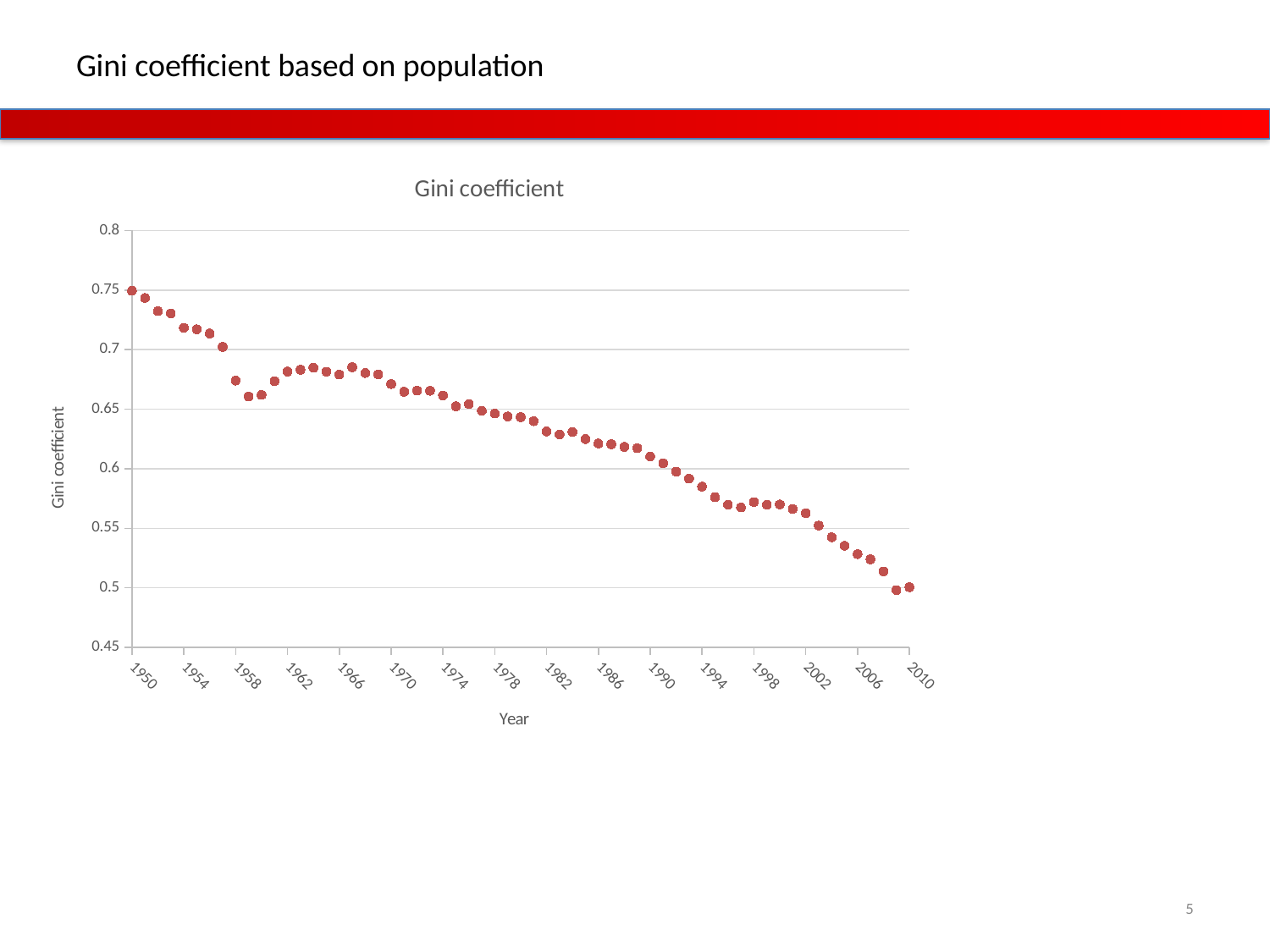
Which year has the larger Gini coefficient, 1950 or 2010? 1950 Is the Gini coefficient for 1998 greater or less than 0.55? greater Is the Gini coefficient for 2006 greater or less than 0.55? less Is the Gini coefficient for 1958 greater or less than 0.7? less Which year has the larger Gini coefficient, 1958 or 1962? 1962 What kind of chart is shown on the slide? scatter chart What is the title of the chart's x axis? Year Do the Gini coefficient values generally rise or fall from 1950 to 2010? fall Which year has the highest Gini coefficient? 1950